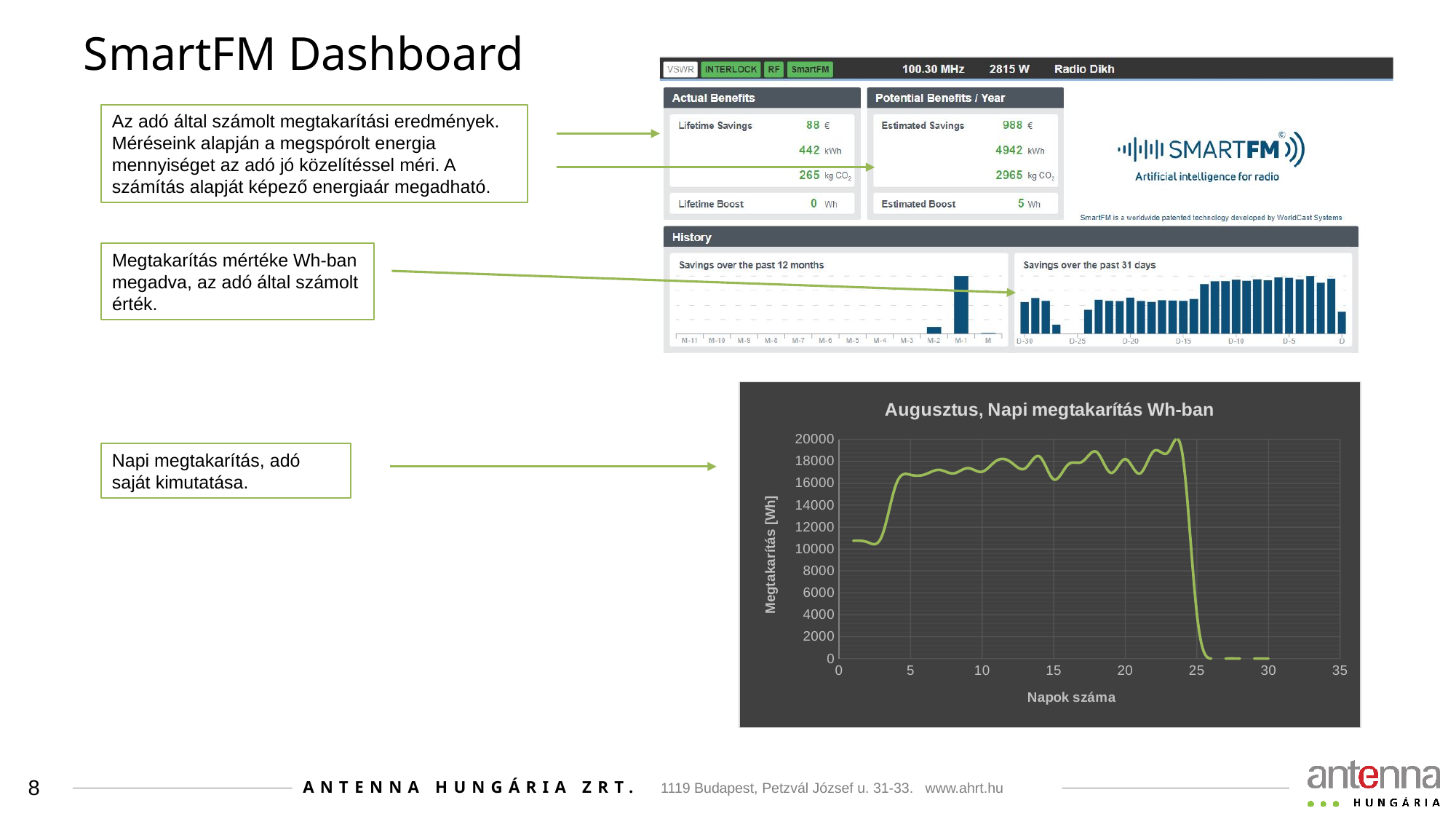
In the 'Augusztus, Napi megtakarítás Wh-ban' chart, what is the label of the x axis? Napok száma In the 'Augusztus, Napi megtakarítás Wh-ban' chart, does the value rise or fall between day 1 and day 5? rise In the 'Savings over the past 12 months' chart in the dashboard screenshot, which month has the highest bar? M-1 In the 'Augusztus, Napi megtakarítás Wh-ban' chart, is the value on day 10 greater or less than 14000? greater In the 'Augusztus, Napi megtakarítás Wh-ban' chart, is the value on day 1 greater or less than 10000? greater In the 'Augusztus, Napi megtakarítás Wh-ban' chart, is the value on day 1 greater or less than 12000? less In the 'Augusztus, Napi megtakarítás Wh-ban' chart, what is the label of the y axis? Megtakarítás [Wh] In the 'Augusztus, Napi megtakarítás Wh-ban' chart, does the value rise or fall between day 24 and day 26? fall What kind of chart is the 'Savings over the past 12 months' chart in the dashboard screenshot? bar chart What kind of chart is the 'Augusztus, Napi megtakarítás Wh-ban' chart? line chart